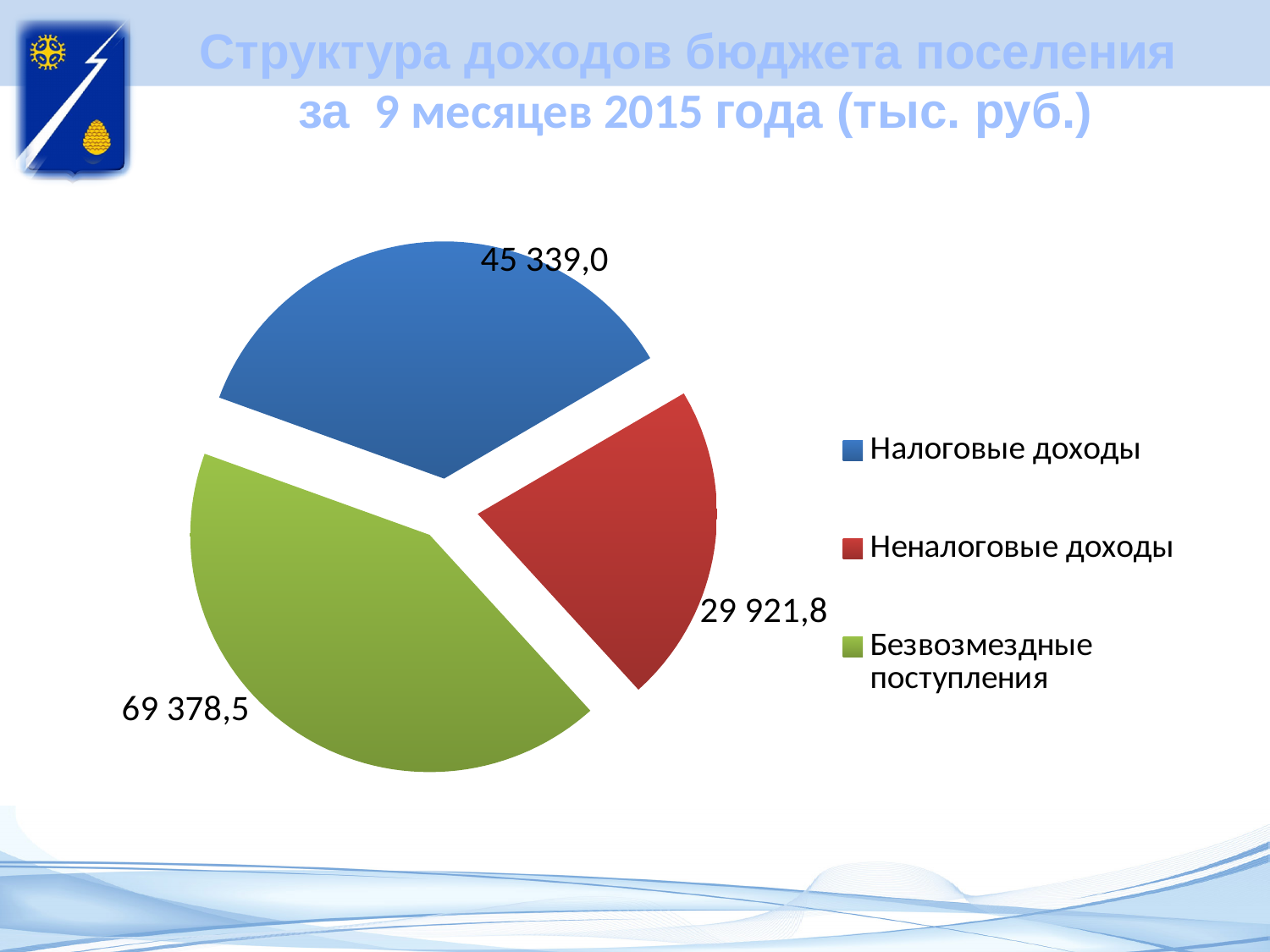
What kind of chart is shown on the slide? Pie chart How many categories does the pie chart show? 3 What is the value for Неналоговые доходы? 29 921,8 Which category has the largest value? Безвозмездные поступления What is the value for Безвозмездные поступления? 69 378,5 Which category has the smallest value? Неналоговые доходы What colour is the slice for Безвозмездные поступления? Green Which is larger, Налоговые доходы or Неналоговые доходы? Налоговые доходы What is the value for Налоговые доходы? 45 339,0 What is the total of all three slices? 144 639,3 What is the difference between Налоговые доходы and Неналоговые доходы? 15 417,2 What is the difference between Безвозмездные поступления and Налоговые доходы? 24 039,5